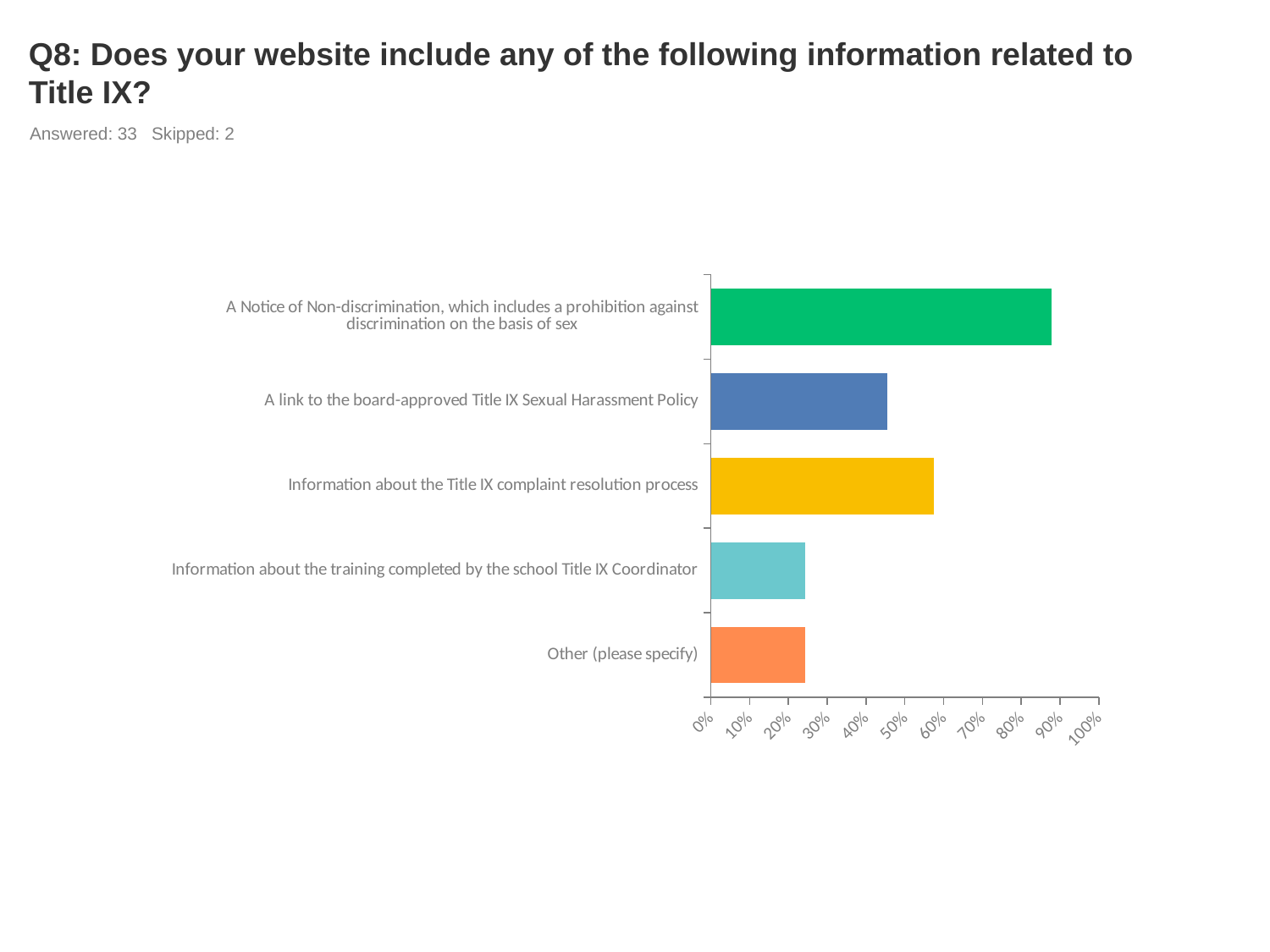
Is the value for "A link to the board-approved Title IX Sexual Harassment Policy" greater or less than 50%? less How many categories are plotted in the chart? 5 Is the value for "Information about the Title IX complaint resolution process" greater or less than 50%? greater What colour is the bar for "A Notice of Non-discrimination, which includes a prohibition against discrimination on the basis of sex"? green Which is larger: the value for "A Notice of Non-discrimination, which includes a prohibition against discrimination on the basis of sex" or the value for "Information about the Title IX complaint resolution process"? A Notice of Non-discrimination, which includes a prohibition against discrimination on the basis of sex Which is larger: the value for "Information about the Title IX complaint resolution process" or the value for "A link to the board-approved Title IX Sexual Harassment Policy"? Information about the Title IX complaint resolution process What is the title of the chart on the slide? Q8: Does your website include any of the following information related to Title IX? Is the value for "A Notice of Non-discrimination, which includes a prohibition against discrimination on the basis of sex" greater or less than 80%? greater Which category has the highest value? A Notice of Non-discrimination, which includes a prohibition against discrimination on the basis of sex What kind of chart is shown on the slide? bar chart